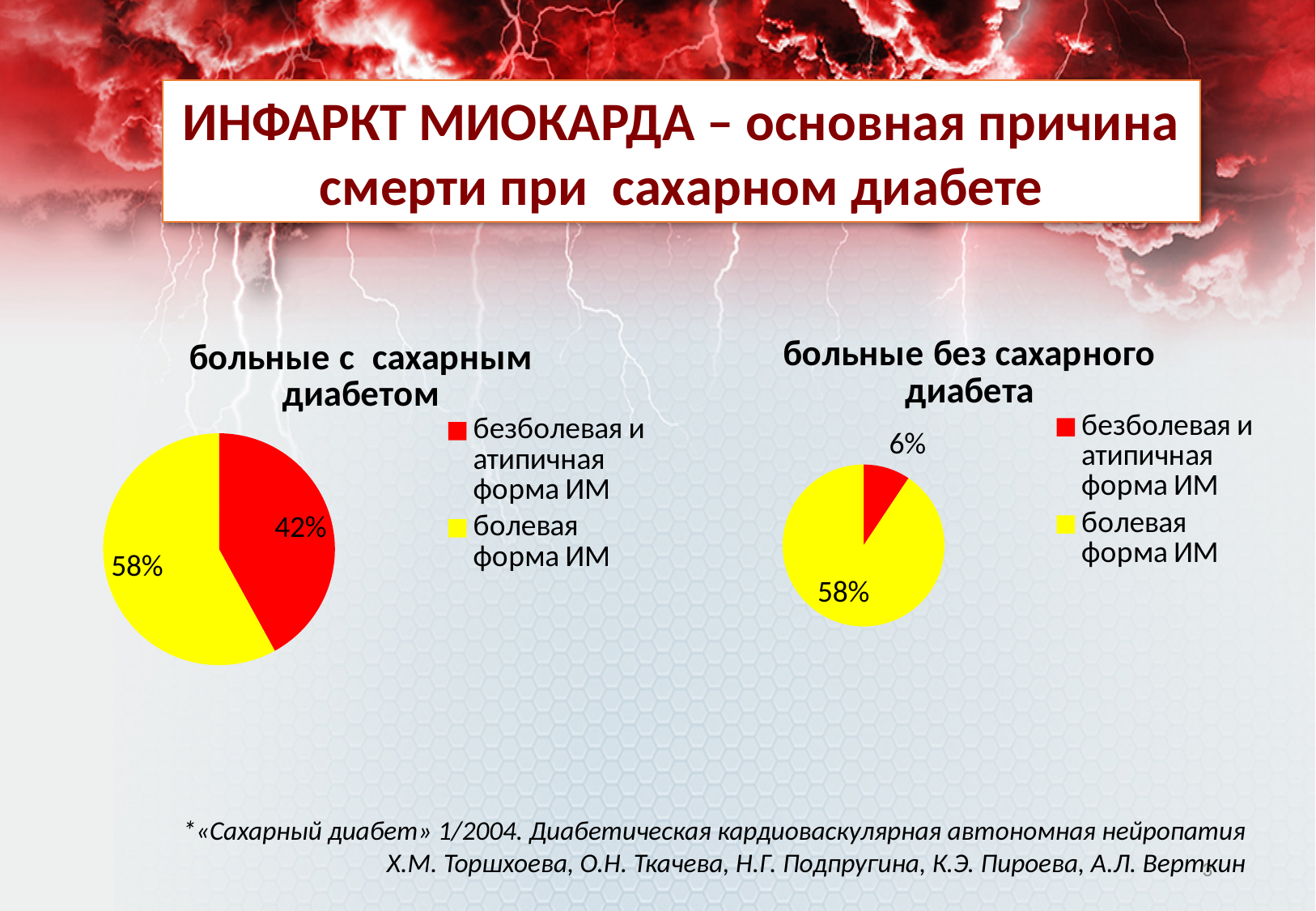
In the "больные без сахарного диабета" chart, which slice is the smallest? безболевая и атипичная форма ИМ In the "больные с сахарным диабетом" chart, what share is labelled for "безболевая и атипичная форма ИМ"? 42% In the "больные с сахарным диабетом" chart, which slice is the largest? болевая форма ИМ In the "больные без сахарного диабета" chart, what value is printed next to the yellow slice? 58% In the "больные с сахарным диабетом" chart, what share is labelled for "болевая форма ИМ"? 58% How many entries does the legend of the "больные без сахарного диабета" chart list? 2 In the "больные с сахарным диабетом" chart, what is the difference between the shares of "болевая форма ИМ" and "безболевая и атипичная форма ИМ"? 16% How many slices does the "больные с сахарным диабетом" pie chart have? 2 What type of chart is used on the slide for "больные с сахарным диабетом"? pie chart In the "больные с сахарным диабетом" chart, what colour is the slice for "болевая форма ИМ"? yellow In the "больные без сахарного диабета" chart, what share is labelled for "безболевая и атипичная форма ИМ"? 6% Which chart shows a larger share for "безболевая и атипичная форма ИМ": "больные с сахарным диабетом" or "больные без сахарного диабета"? больные с сахарным диабетом